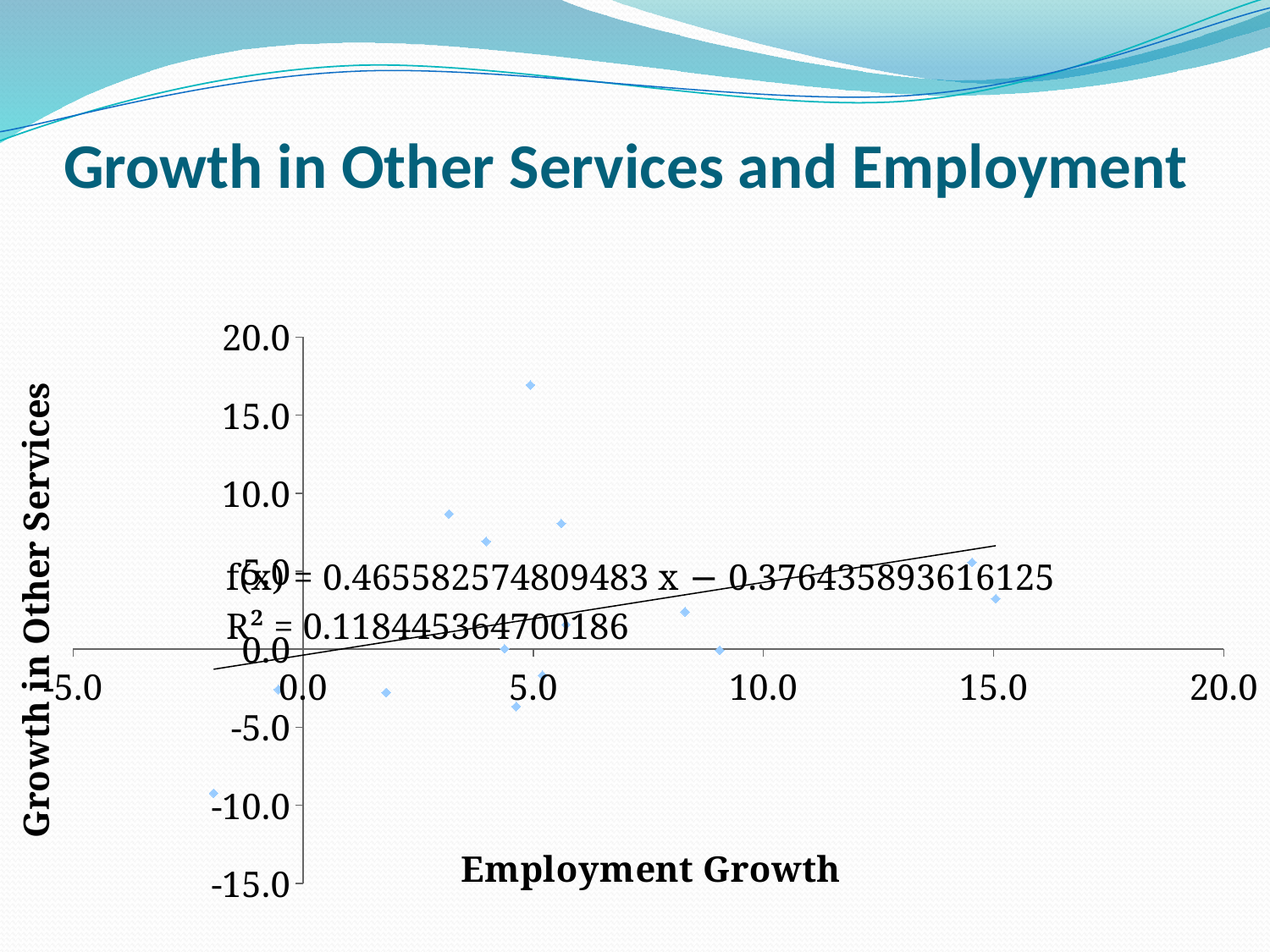
Is the highest plotted Growth in Other Services value greater or less than 15.0? greater Is the largest Employment Growth value among the plotted points greater or less than 20.0? less What is the trendline equation shown on the chart? f(x) = 0.465582574809483 x − 0.376435893616125 What is the R² value shown on the chart? 0.118445364700186 What is the minimum value shown on the x axis? -5.0 Does the fitted trendline rise or fall as Employment Growth increases? rise What is the label of the x axis? Employment Growth Is the lowest plotted Growth in Other Services value greater or less than -5.0? less What is the title of the chart? Growth in Other Services and Employment What kind of chart is shown on the slide? scatter plot What is the maximum value shown on the y axis? 20.0